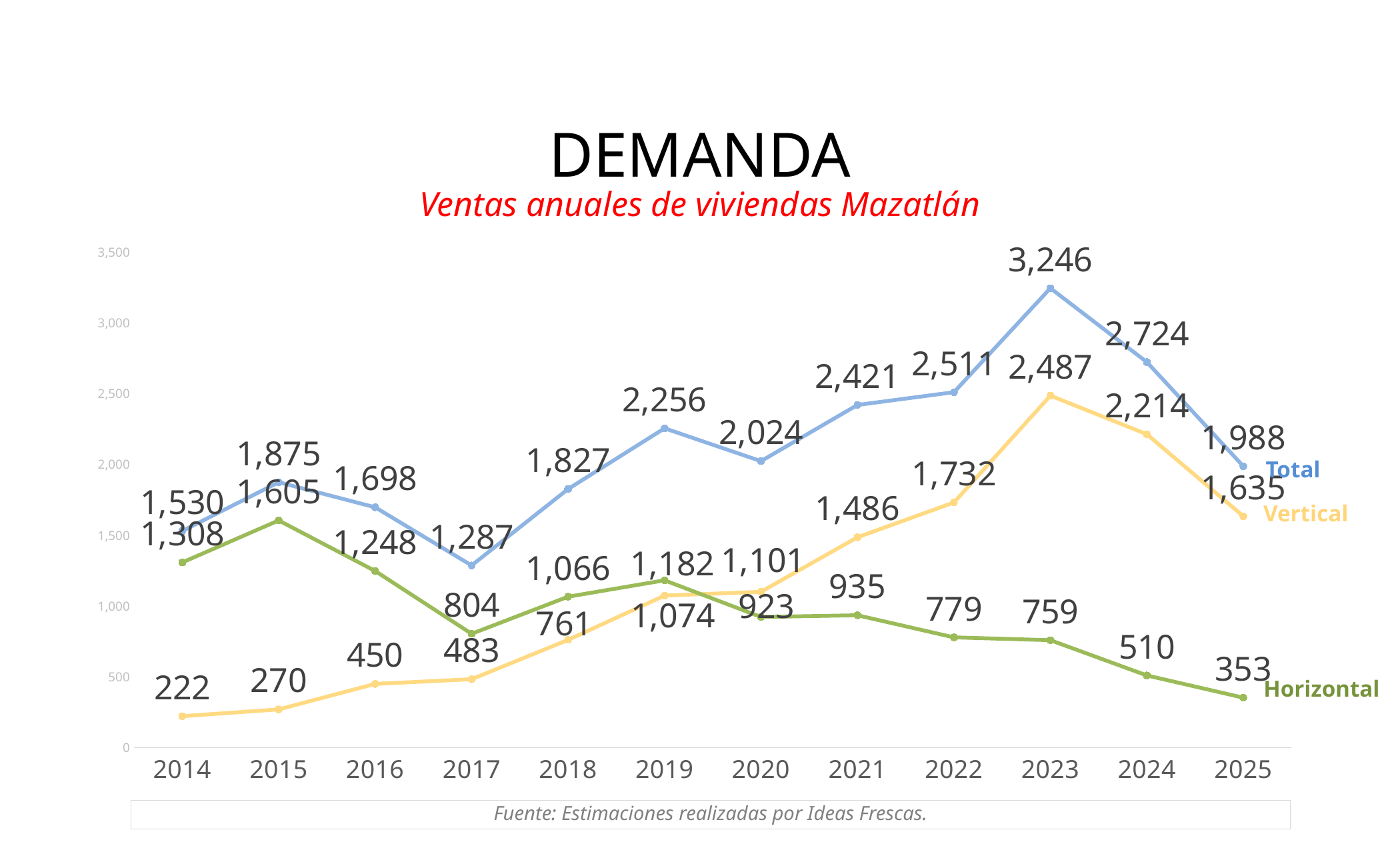
What is the Vertical value for 2019? 1,074 What is the Horizontal value for 2025? 353 What is the subtitle of the chart shown in red? Ventas anuales de viviendas Mazatlán How many series are plotted on the chart? 3 Which is larger in 2020, the Vertical value or the Horizontal value? Vertical Does the Horizontal series rise or fall from 2021 to 2025? Fall What is the difference between the Total values for 2023 and 2024? 522 What is the Total value for 2023? 3,246 In which year is the Total series highest? 2023 How many years are shown on the x axis? 12 In which year is the Vertical series lowest? 2014 What kind of chart is shown on the slide? Line chart